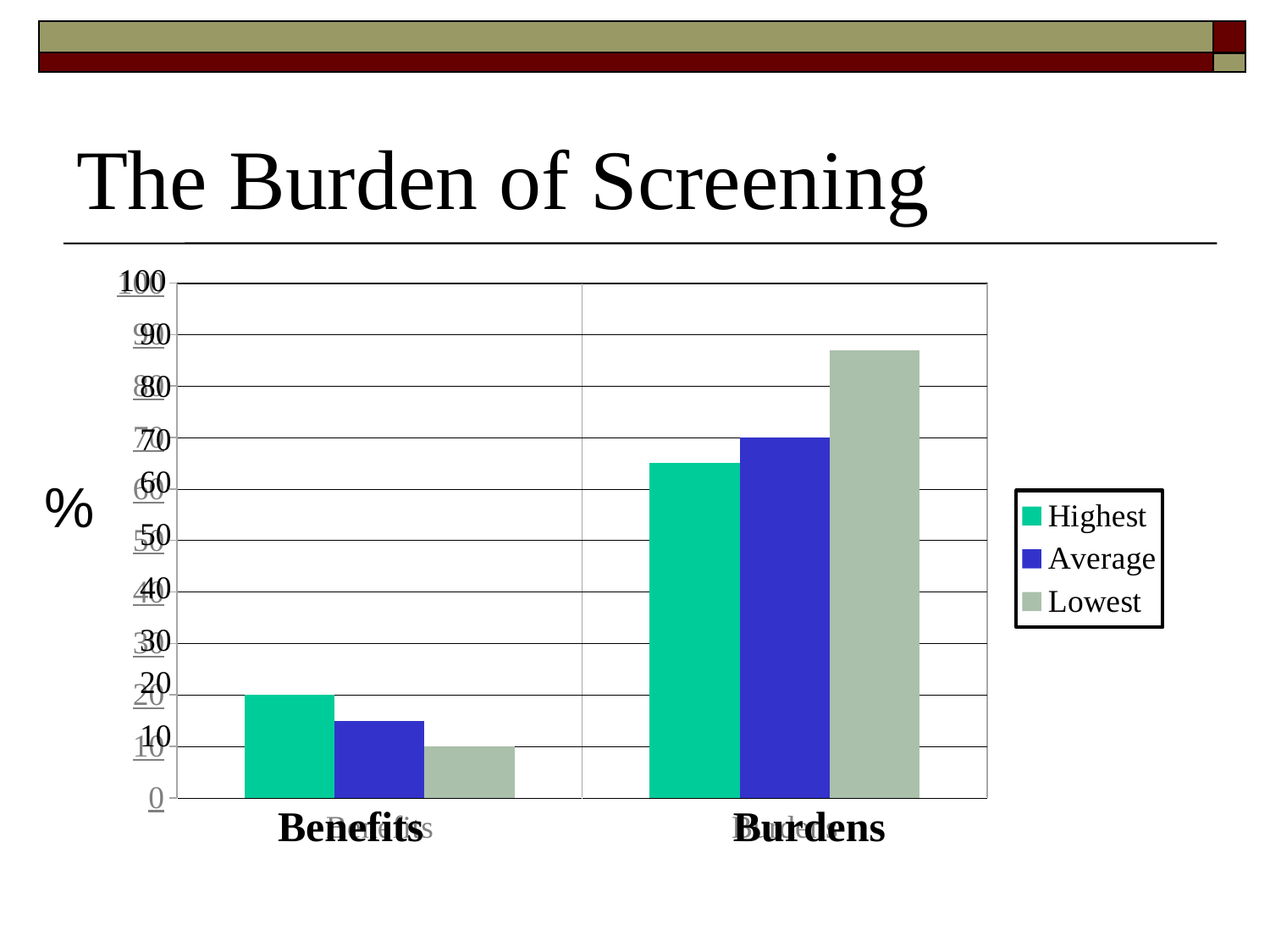
Which series has the shortest bar for Benefits? Lowest Is the Highest value for Burdens greater or less than 60? greater Which is larger, the Highest value for Benefits or the Highest value for Burdens? Burdens What is the Lowest value for Benefits? 10 Is the Lowest value for Burdens greater or less than 80? greater What is the Average value for Burdens? 70 How many categories are shown on the x axis? 2 Which series has the tallest bar for Burdens? Lowest Is the Average value for Benefits greater or less than 20? less What is the Highest value for Benefits? 20 How many series does the legend list? 3 What kind of chart is shown on the slide? bar chart